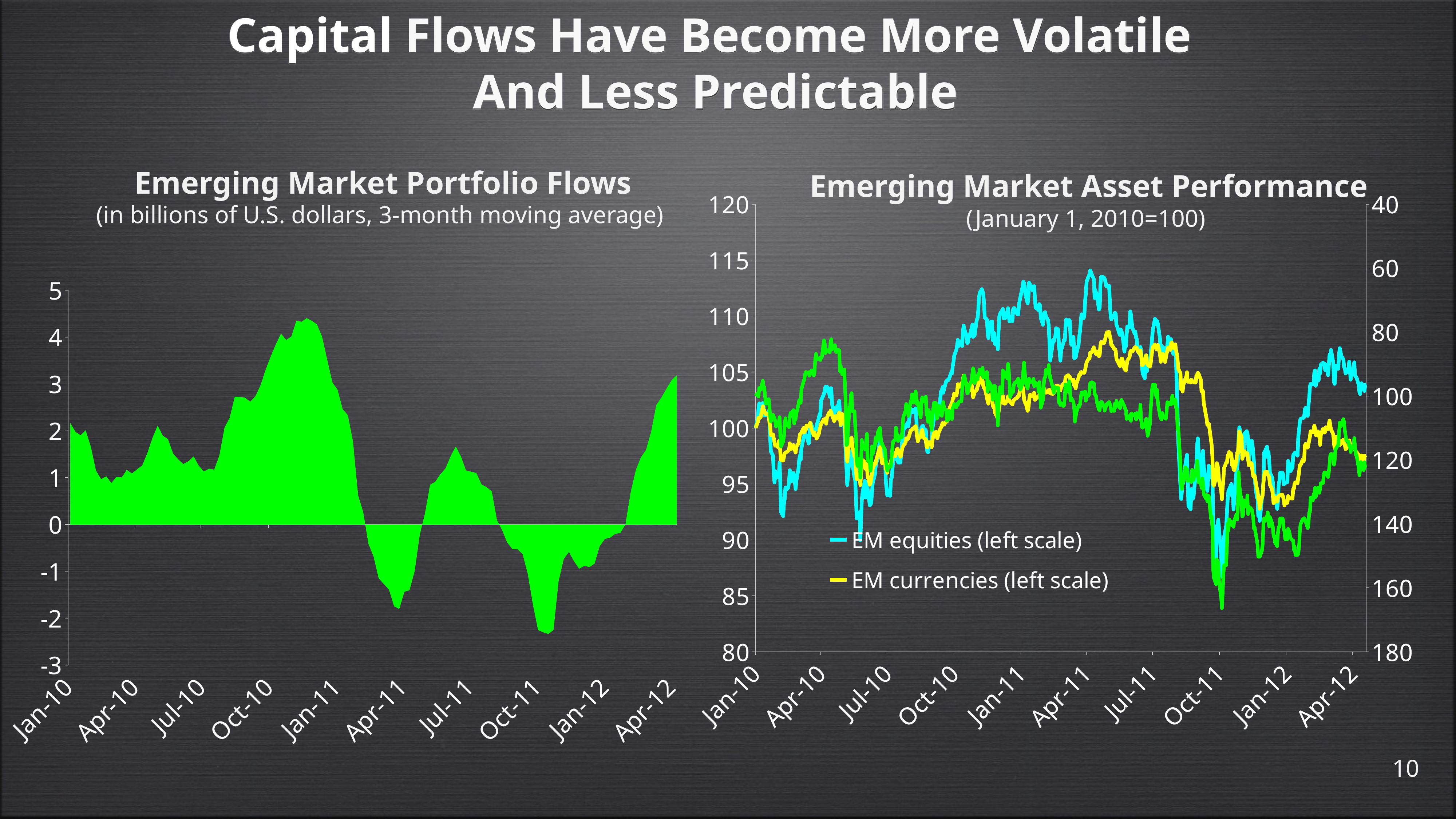
In the Emerging Market Asset Performance chart, is the EM equities value at Oct-11 greater or less than 100 on the left scale? less What units are given in the subtitle of the Emerging Market Portfolio Flows chart? in billions of U.S. dollars, 3-month moving average In the Emerging Market Portfolio Flows chart, is the value at Apr-11 greater or less than 0? less How many date labels are shown on the x axis of the Emerging Market Portfolio Flows chart? 10 In the Emerging Market Portfolio Flows chart, is the value at Oct-11 greater or less than -1? less What kind of chart is the Emerging Market Portfolio Flows chart on the left? Area chart What kind of chart is the Emerging Market Asset Performance chart on the right? Line chart In the Emerging Market Portfolio Flows chart, do the values rise or fall between Jan-11 and Apr-11? fall How many series does the legend of the Emerging Market Asset Performance chart list? 2